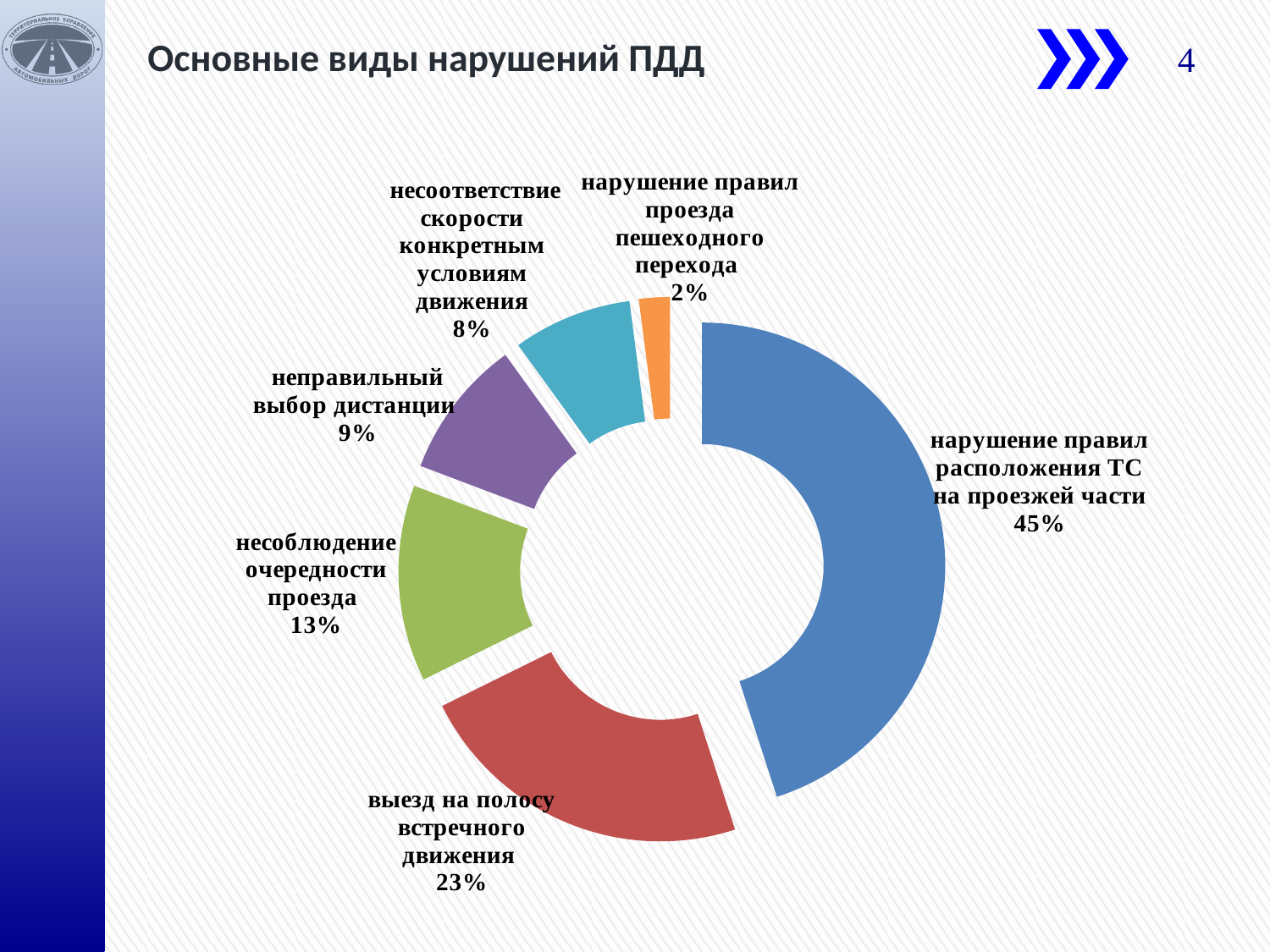
What colour is the segment for "выезд на полосу встречного движения"? red Which is larger: the share for "несоответствие скорости конкретным условиям движения" or for "неправильный выбор дистанции"? неправильный выбор дистанции What is the value for "неправильный выбор дистанции"? 9% What kind of chart is shown on the slide? doughnut chart What is the title of the slide? Основные виды нарушений ПДД What share of the chart does "нарушение правил расположения ТС на проезжей части" account for? 45% What percentage is shown for "несоблюдение очередности проезда"? 13% What is the difference between the shares of "нарушение правил расположения ТС на проезжей части" and "выезд на полосу встречного движения"? 22% Which category has the largest share of the chart? нарушение правил расположения ТС на проезжей части Which category has the smallest share of the chart? нарушение правил проезда пешеходного перехода What is the value shown for "выезд на полосу встречного движения"? 23% How many categories are shown in the chart? 6